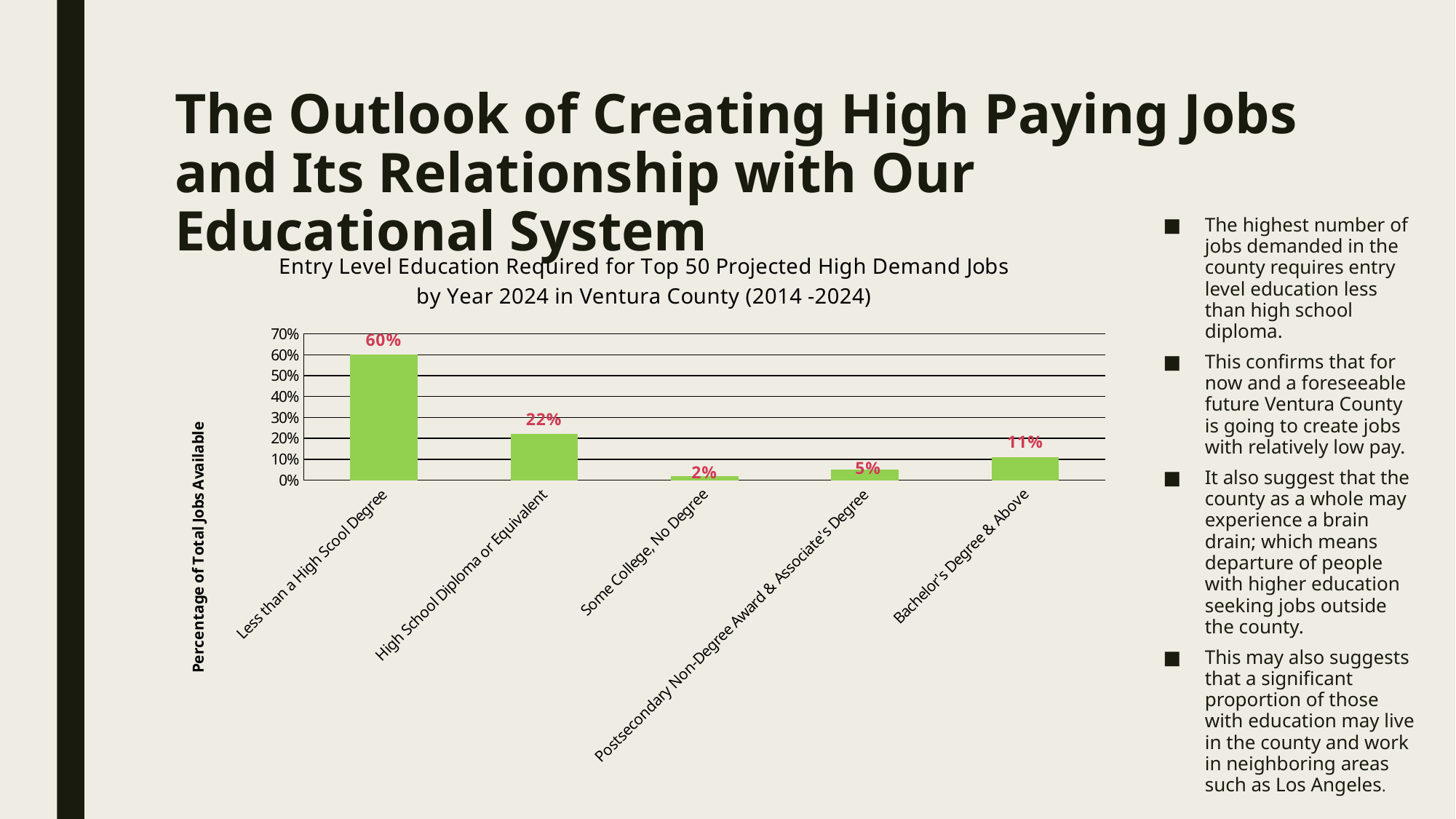
Which education category has the lowest percentage of total jobs available? Some College, No Degree What is the value for Some College, No Degree? 2% Which is larger: the value for Bachelor's Degree & Above or the value for Postsecondary Non-Degree Award & Associate's Degree? Bachelor's Degree & Above What is the value for Bachelor's Degree & Above? 11% What percentage of total jobs available requires less than a high school degree? 60% What kind of chart is shown on the slide? Bar chart What is the value for High School Diploma or Equivalent? 22% Which education category has the highest percentage of total jobs available? Less than a High Scool Degree What is the difference between the values for Bachelor's Degree & Above and Postsecondary Non-Degree Award & Associate's Degree? 6% What is the difference between the values for Less than a High Scool Degree and High School Diploma or Equivalent? 38% How many education categories are shown on the x axis of the chart? 5 What is the label of the vertical axis of the chart? Percentage of Total Jobs Available